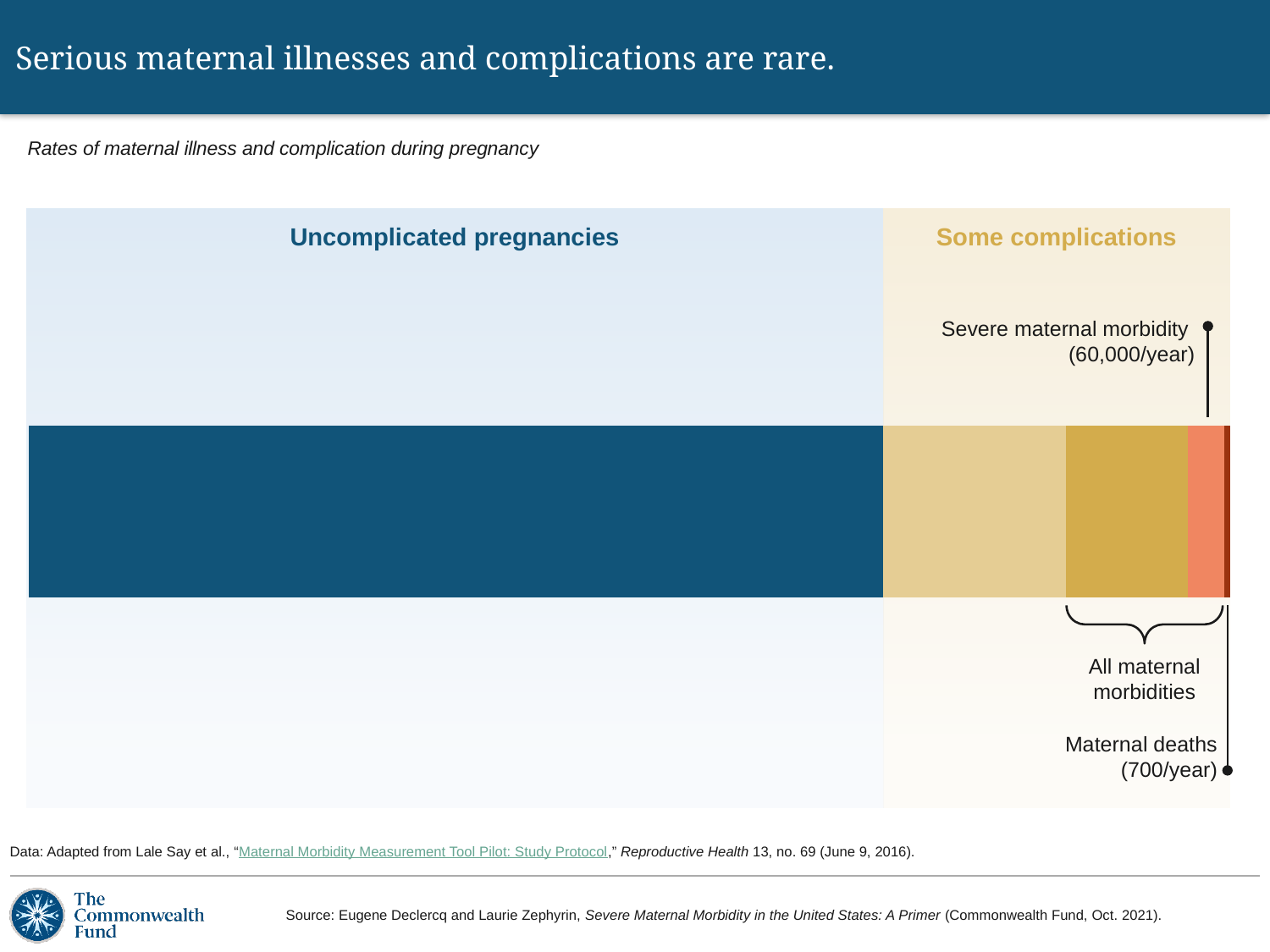
Which labelled segment of the bar is the smallest? Maternal deaths What kind of chart is shown on the slide? Bar chart Which segment is wider: Uncomplicated pregnancies or Some complications? Uncomplicated pregnancies What is the difference between the annual number of severe maternal morbidity cases and the annual number of maternal deaths? 59,300 What label is given to the large dark blue segment of the bar? Uncomplicated pregnancies What is the subtitle describing the chart? Rates of maternal illness and complication during pregnancy Which is larger: the number of severe maternal morbidity cases per year or the number of maternal deaths per year? Severe maternal morbidity Which segment of the bar is the largest? Uncomplicated pregnancies What is the annual number given for maternal deaths? 700/year What is the annual number given for severe maternal morbidity? 60,000/year